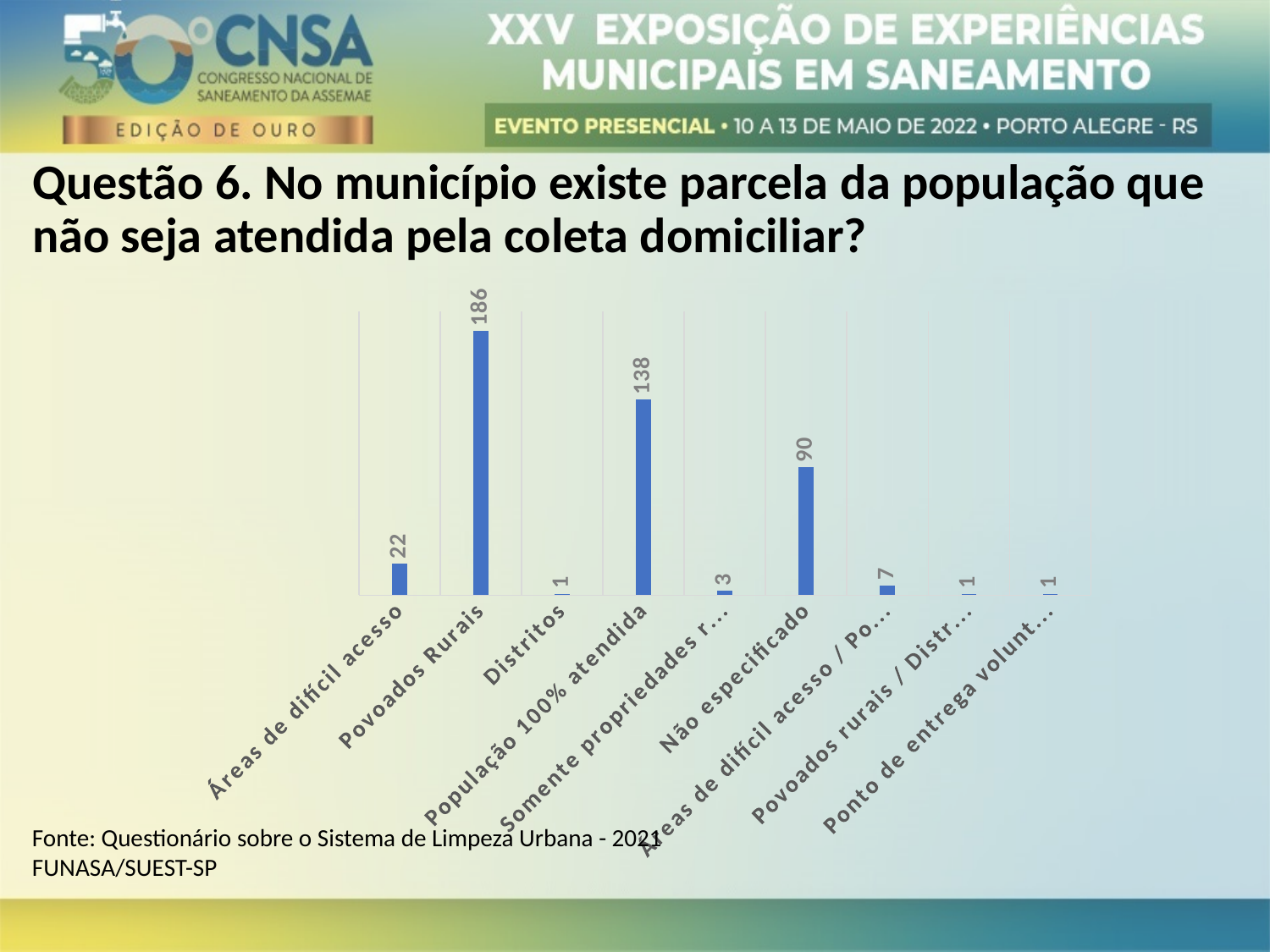
Which is larger, the value for População 100% atendida or the value for Não especificado? População 100% atendida What value is shown for Povoados Rurais? 186 Which category has the highest value? Povoados Rurais What value is shown for Distritos? 1 What value is shown for População 100% atendida? 138 What is the difference between the values for Não especificado and Áreas de difícil acesso? 68 How many categories are shown on the x axis of the chart? 9 What kind of chart is shown on the slide? Bar chart What value is shown for Áreas de difícil acesso? 22 What colour are the bars in the chart? Blue What value is shown for Não especificado? 90 What is the difference between the values for Povoados Rurais and População 100% atendida? 48